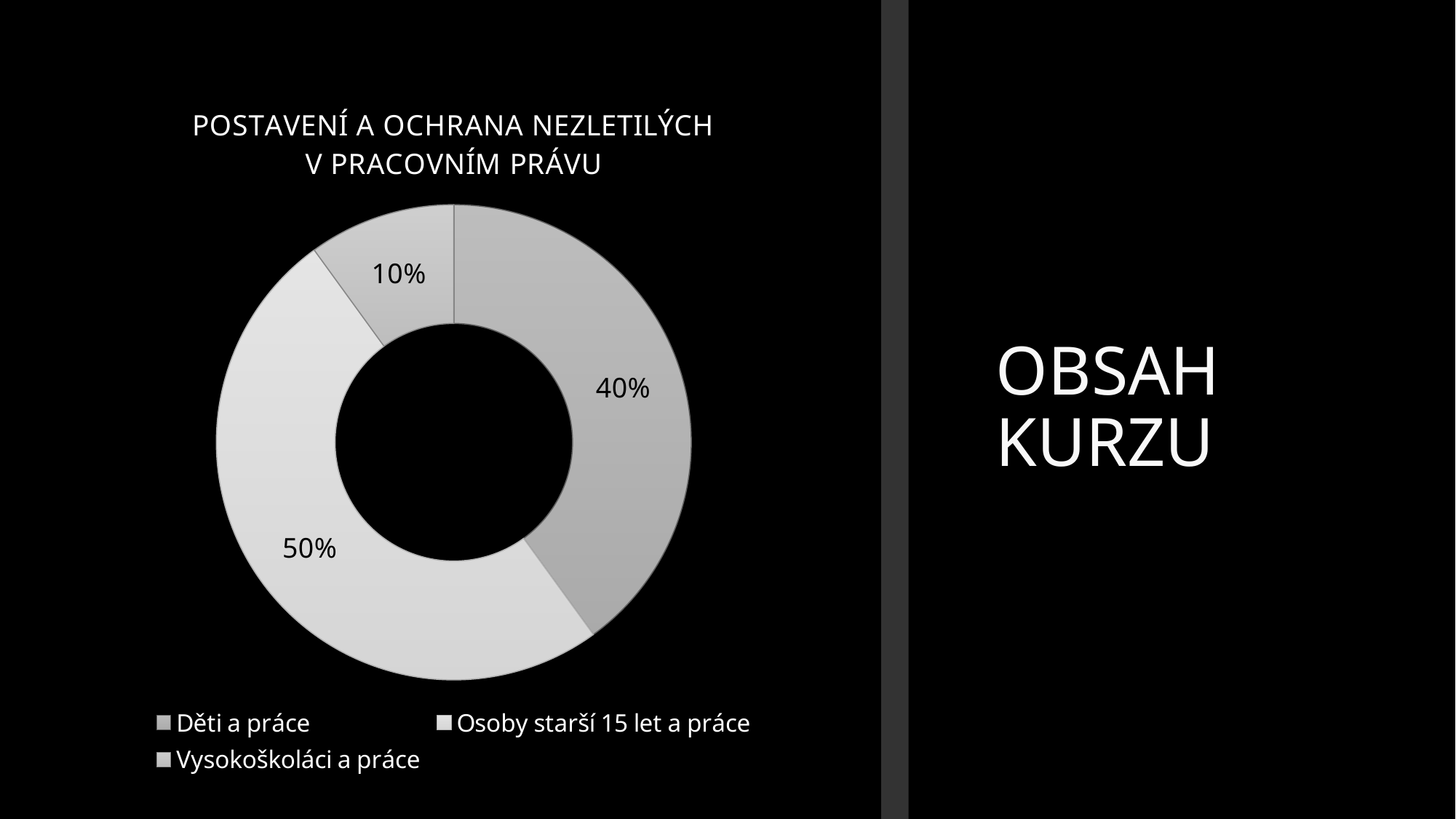
Which category has the smallest share of the chart? Vysokoškoláci a práce What percentage is shown for Osoby starší 15 let a práce? 50% How many categories does the chart show? 3 What is the difference in percentage points between Osoby starší 15 let a práce and Děti a práce? 10 Which is larger, the share for Děti a práce or the share for Vysokoškoláci a práce? Děti a práce What percentage is shown for Vysokoškoláci a práce? 10% Which legend entry is listed first? Děti a práce What is the difference in percentage points between Děti a práce and Vysokoškoláci a práce? 30 What is the title of the chart? POSTAVENÍ A OCHRANA NEZLETILÝCH V PRACOVNÍM PRÁVU What share of the doughnut chart is labelled for Děti a práce? 40% Which category has the largest share of the chart? Osoby starší 15 let a práce What kind of chart is shown on the slide? Doughnut chart